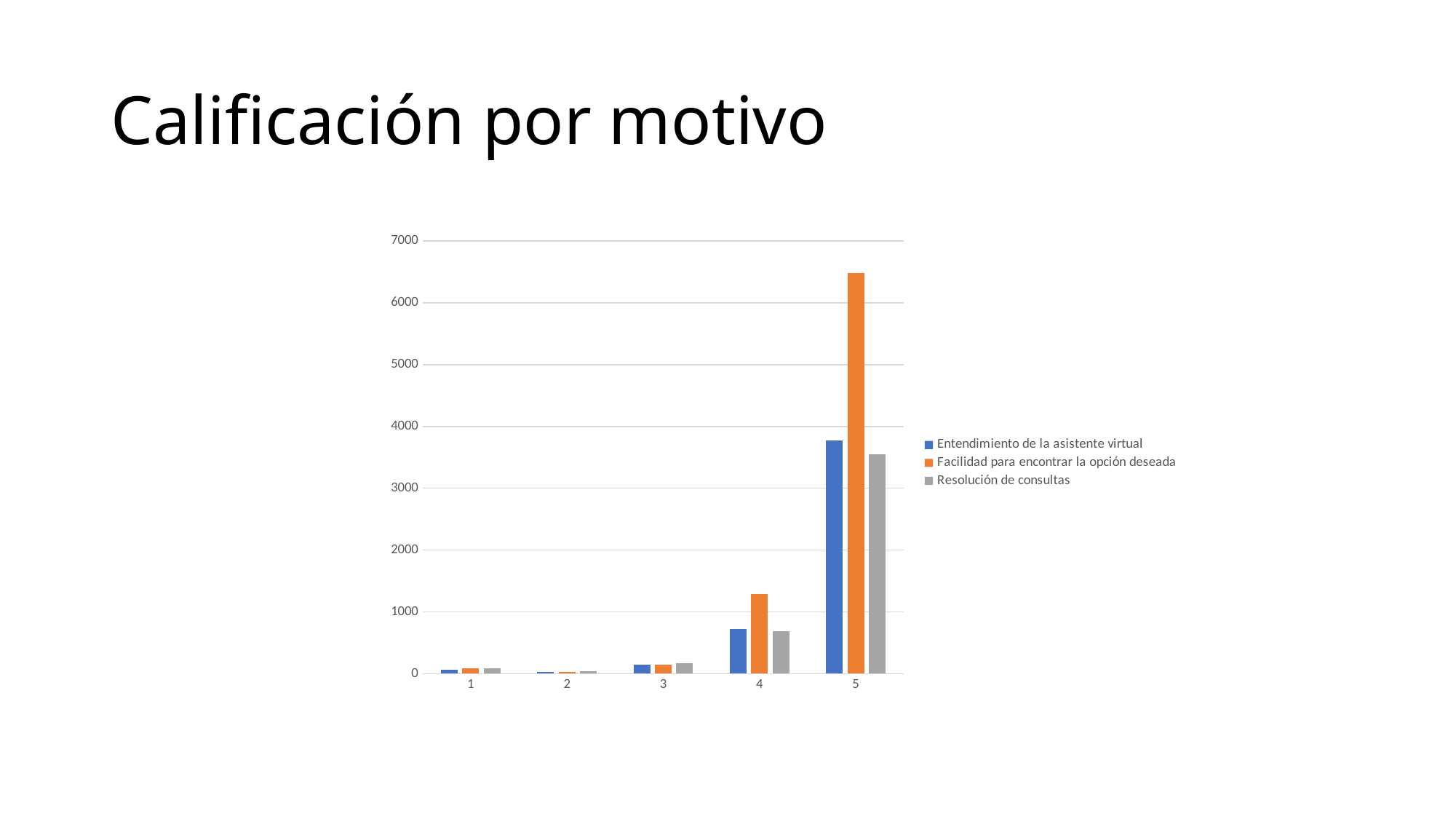
How many series does the legend list? 3 For which rating category is the bar for 'Facilidad para encontrar la opción deseada' highest? 5 Is the value for 'Entendimiento de la asistente virtual' at rating 5 greater or less than 4000? less Which rating category has the lowest bars for all three series? 2 At rating 5, which series has the larger value: 'Entendimiento de la asistente virtual' or 'Facilidad para encontrar la opción deseada'? Facilidad para encontrar la opción deseada Is the value for 'Facilidad para encontrar la opción deseada' at rating 4 greater or less than 1000? greater Is the value for 'Facilidad para encontrar la opción deseada' at rating 5 greater or less than 6000? greater What kind of chart is shown on the slide? bar chart Do the values for 'Facilidad para encontrar la opción deseada' rise or fall from rating 3 to rating 5? rise What colour represents 'Resolución de consultas' in the legend? gray How many rating categories are shown on the x axis? 5